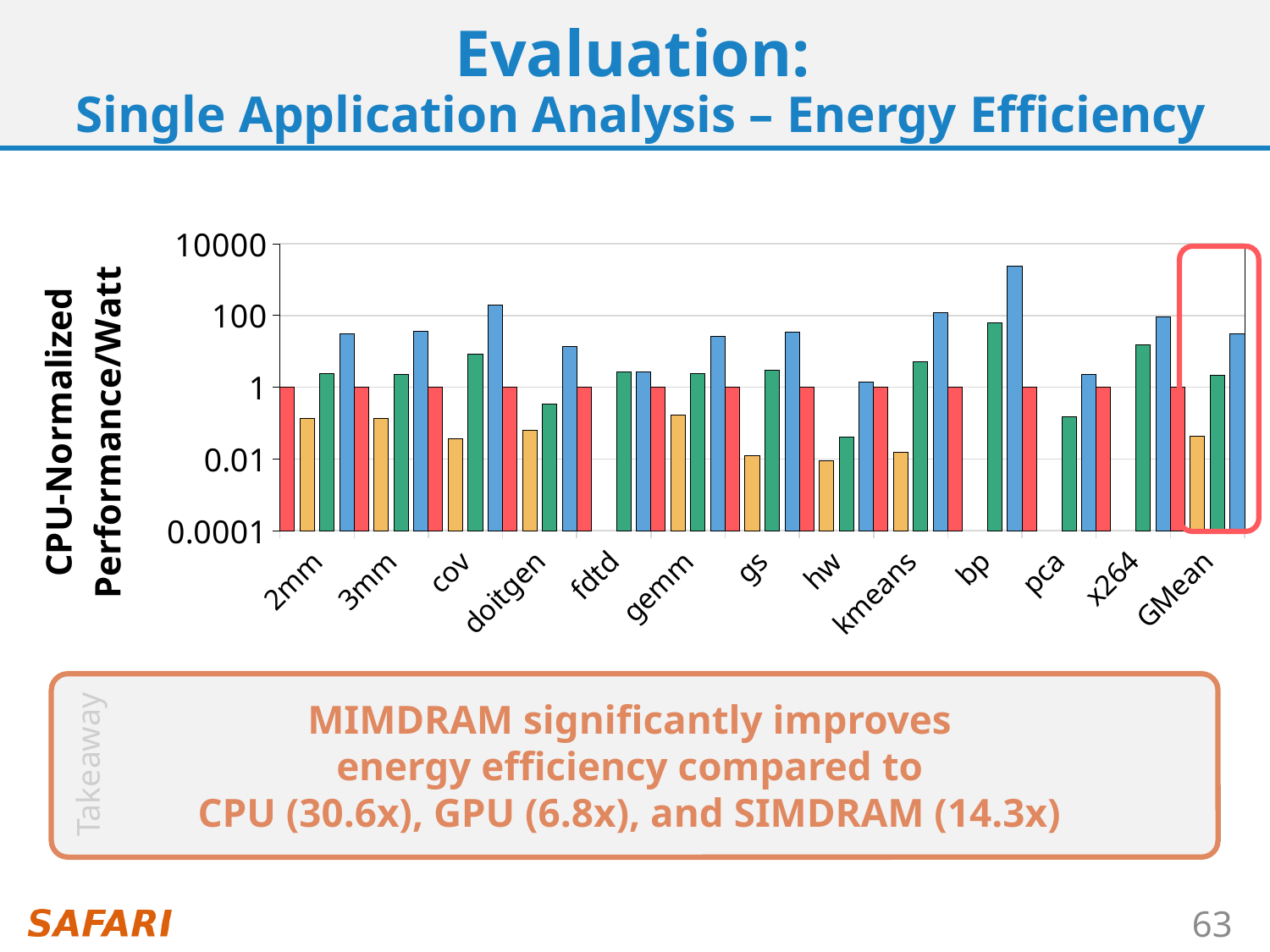
What kind of chart is shown on the slide? bar chart What is the y-axis label of the chart? CPU-Normalized Performance/Watt Is the value of the blue bar for bp greater or less than 100? greater Which is larger, the blue bar for bp or the blue bar for pca? bp What is the value of the red bar for 2mm? 1 What is the value of the red bar for GMean? 1 How many application categories are shown on the x axis of the chart? 13 Which category has the highest blue bar in the chart? bp Is the value of the blue bar for 2mm greater or less than 1? greater Is the value of the orange bar for GMean greater or less than 1? less